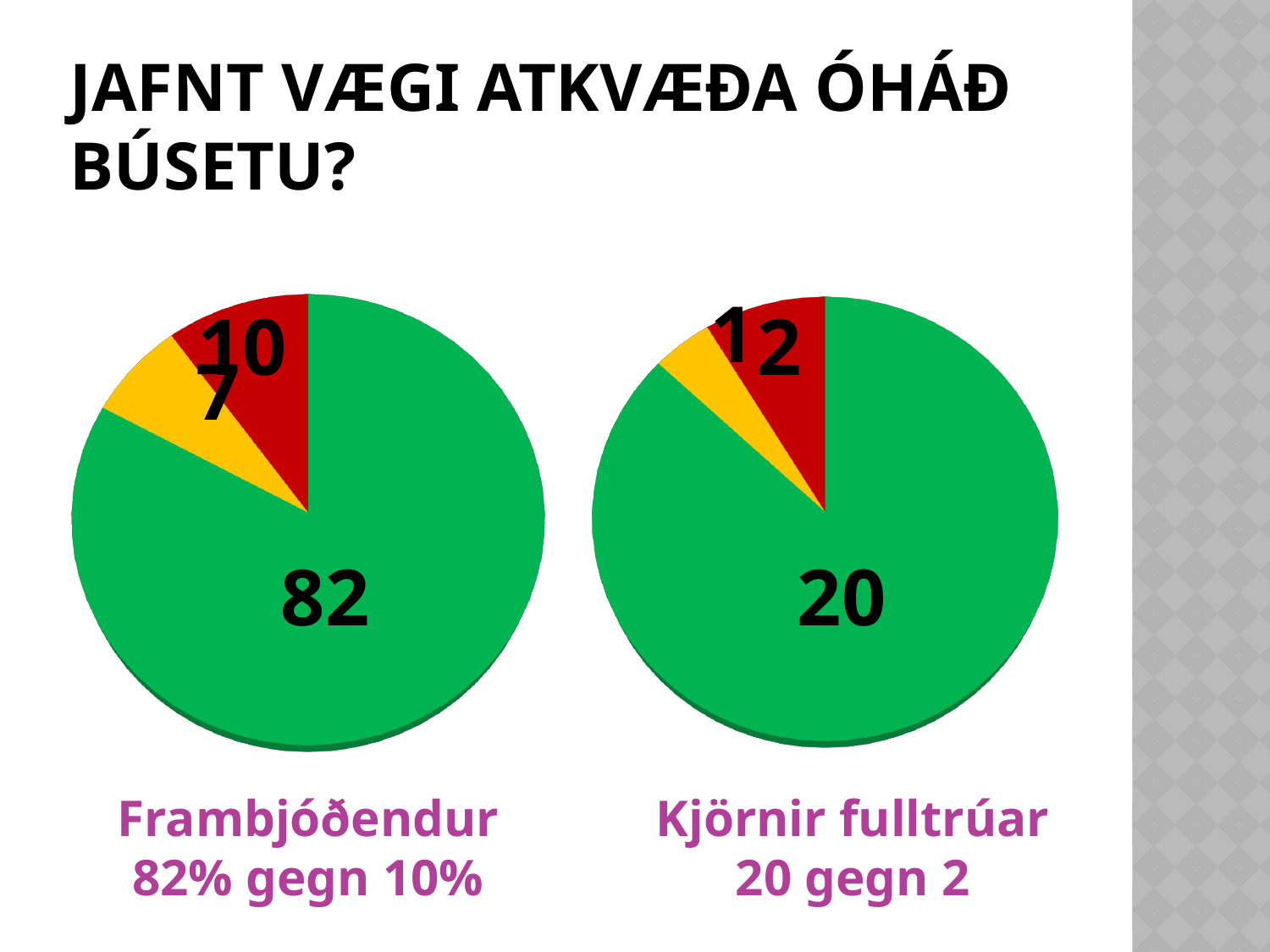
What kind of chart is used for the Frambjóðendur data on the left? pie chart In the Frambjóðendur pie chart on the left, what value is shown on the red slice? 10 In the Frambjóðendur pie chart on the left, which is larger, the red slice or the yellow slice? red In the Frambjóðendur pie chart on the left, what is the difference between the green slice value and the red slice value? 72 In the Kjörnir fulltrúar pie chart on the right, what value is shown on the green slice? 20 In the Kjörnir fulltrúar pie chart on the right, which colour slice has the smallest value? yellow What is the sum of the three values shown in the Kjörnir fulltrúar pie chart on the right? 23 In the Frambjóðendur pie chart on the left, what value is shown on the green slice? 82 In the Frambjóðendur pie chart on the left, which colour slice has the largest value? green How many slices does the Kjörnir fulltrúar pie chart on the right have? 3 In the Frambjóðendur pie chart on the left, what value is shown on the yellow slice? 7 In the Kjörnir fulltrúar pie chart on the right, what value is shown on the red slice? 2